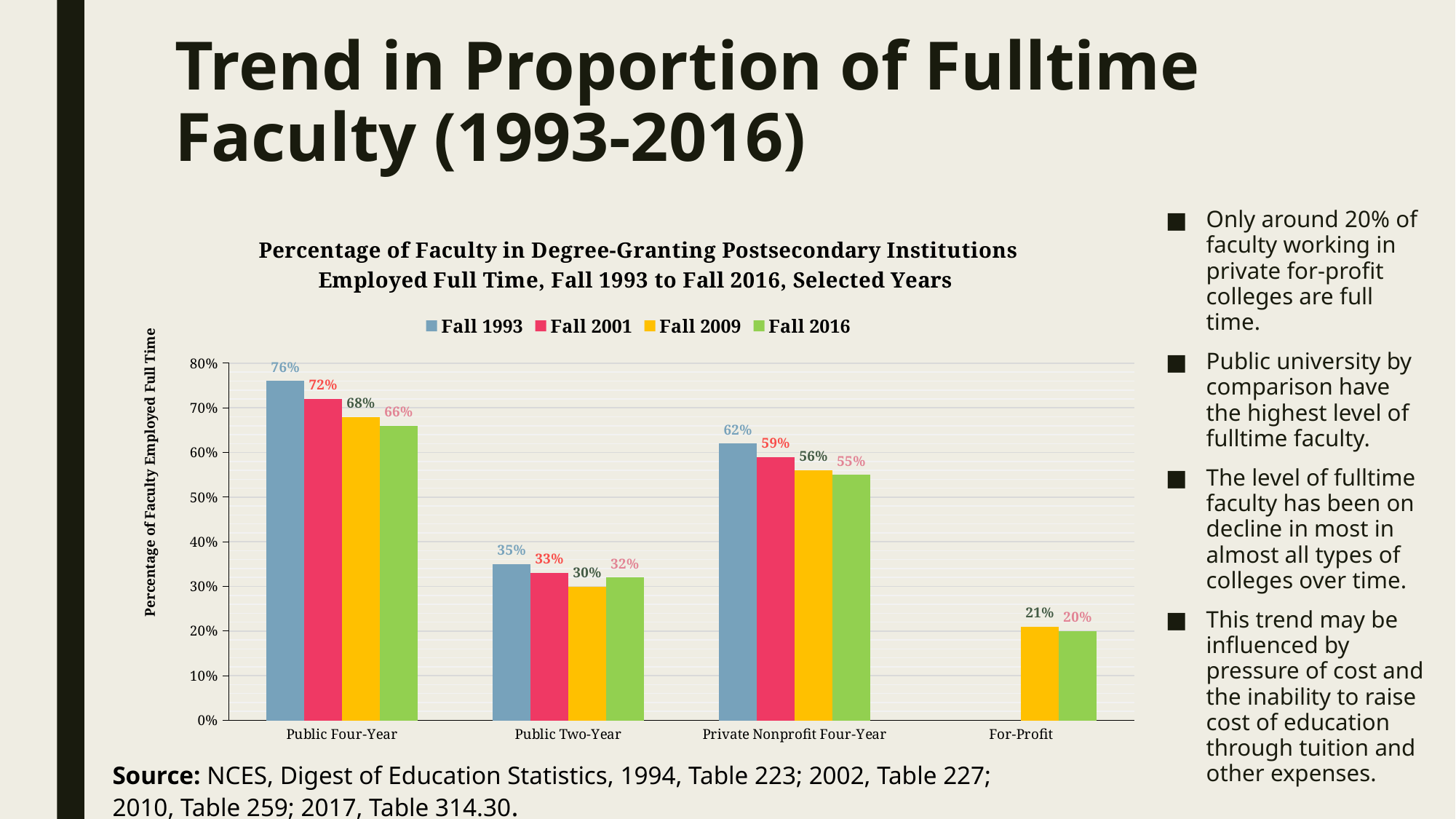
What percentage of faculty at Public Four-Year institutions were employed full time in Fall 1993? 76% For Private Nonprofit Four-Year institutions, do the values rise or fall from Fall 1993 to Fall 2016? Fall How many institution types are shown on the x axis? 4 What is the Fall 2016 value for Private Nonprofit Four-Year institutions? 55% How many series does the legend list? 4 Which institution type has the lowest Fall 2016 value? For-Profit Which series is shown in yellow in the legend? Fall 2009 What kind of chart is shown on the slide? Bar chart What is the difference between the Fall 1993 and Fall 2016 values for Public Four-Year institutions? 10% What is the Fall 2009 value for For-Profit institutions? 21% Which institution type has the highest Fall 1993 value? Public Four-Year Which is larger: the Fall 2001 value for Public Two-Year or the Fall 2009 value for Public Two-Year? Fall 2001